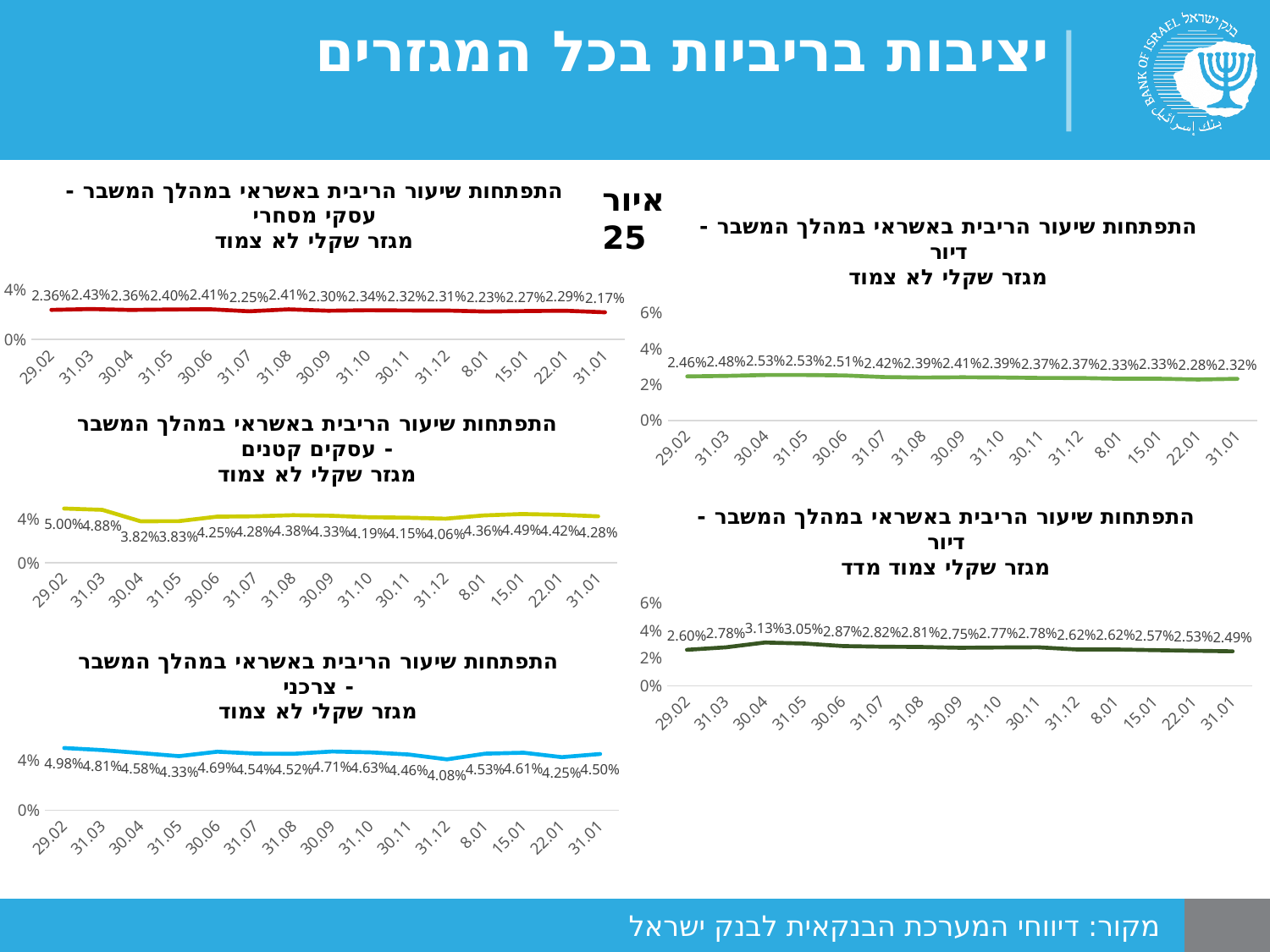
How many data points are plotted in the top-right chart (housing, unindexed shekel sector)? 15 What type of chart is the bottom-left chart (consumer, unindexed shekel sector)? Line chart In the top-left chart (commercial business, unindexed shekel sector), which date has the lowest value? 31.01 In the bottom-right chart (housing, CPI-indexed shekel sector), which date has the highest value? 30.04 In the bottom-right chart (housing, CPI-indexed shekel sector), what is the value at 30.04? 3.13% In the middle-left chart (small businesses, unindexed shekel sector), which date has the highest value? 29.02 In the bottom-left chart (consumer, unindexed shekel sector), what is the value at 31.12? 4.08% In the top-right chart (housing, unindexed shekel sector), what is the value at 29.02? 2.46% In the top-right chart (housing, unindexed shekel sector), what is the value at 31.01? 2.32% In the middle-left chart (small businesses, unindexed shekel sector), what is the value at 30.04? 3.82% In the bottom-right chart (housing, CPI-indexed shekel sector), what is the difference between the value at 30.04 and the value at 31.01? 0.64% In the bottom-left chart (consumer, unindexed shekel sector), which is larger: the value at 29.02 or the value at 31.01? 29.02